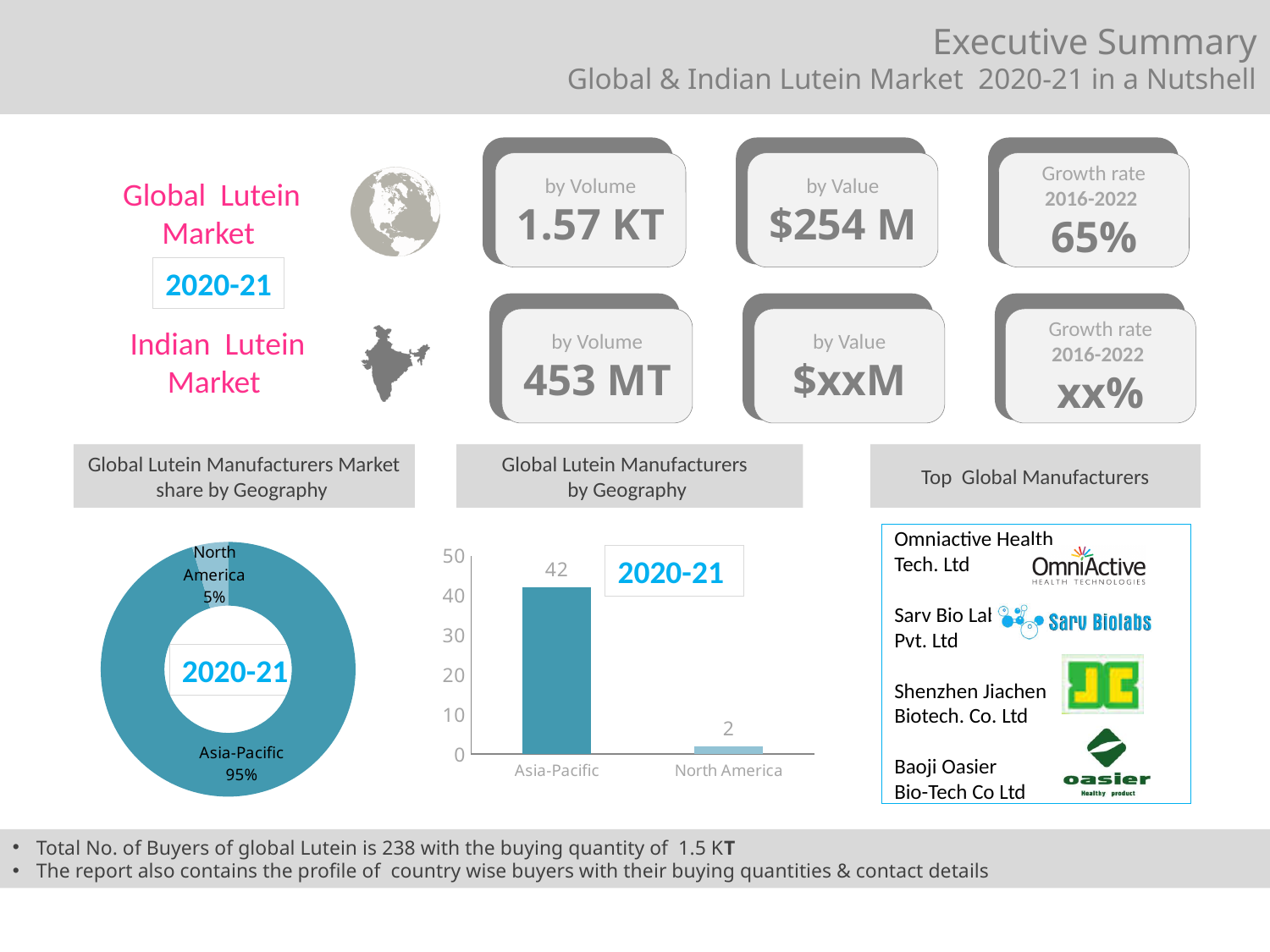
How many slices does the 'Global Lutein Manufacturers Market share by Geography' chart have? 2 What year label is shown inside the 'Global Lutein Manufacturers Market share by Geography' doughnut chart? 2020-21 In the 'Global Lutein Manufacturers Market share by Geography' chart, which region has the largest share? Asia-Pacific In the 'Global Lutein Manufacturers Market share by Geography' chart, what share does Asia-Pacific hold? 95% In the 'Global Lutein Manufacturers by Geography' chart, is the value for Asia-Pacific greater or less than 40? greater What kind of chart is the 'Global Lutein Manufacturers Market share by Geography' chart? Doughnut (pie) chart In the 'Global Lutein Manufacturers by Geography' chart, what is the value for North America? 2 What kind of chart is the 'Global Lutein Manufacturers by Geography' chart? Bar chart In the 'Global Lutein Manufacturers by Geography' chart, which region has the lowest value? North America In the 'Global Lutein Manufacturers by Geography' chart, what is the value for Asia-Pacific? 42 In the 'Global Lutein Manufacturers by Geography' chart, what is the difference between Asia-Pacific and North America? 40 In the 'Global Lutein Manufacturers Market share by Geography' chart, what share does North America hold? 5%